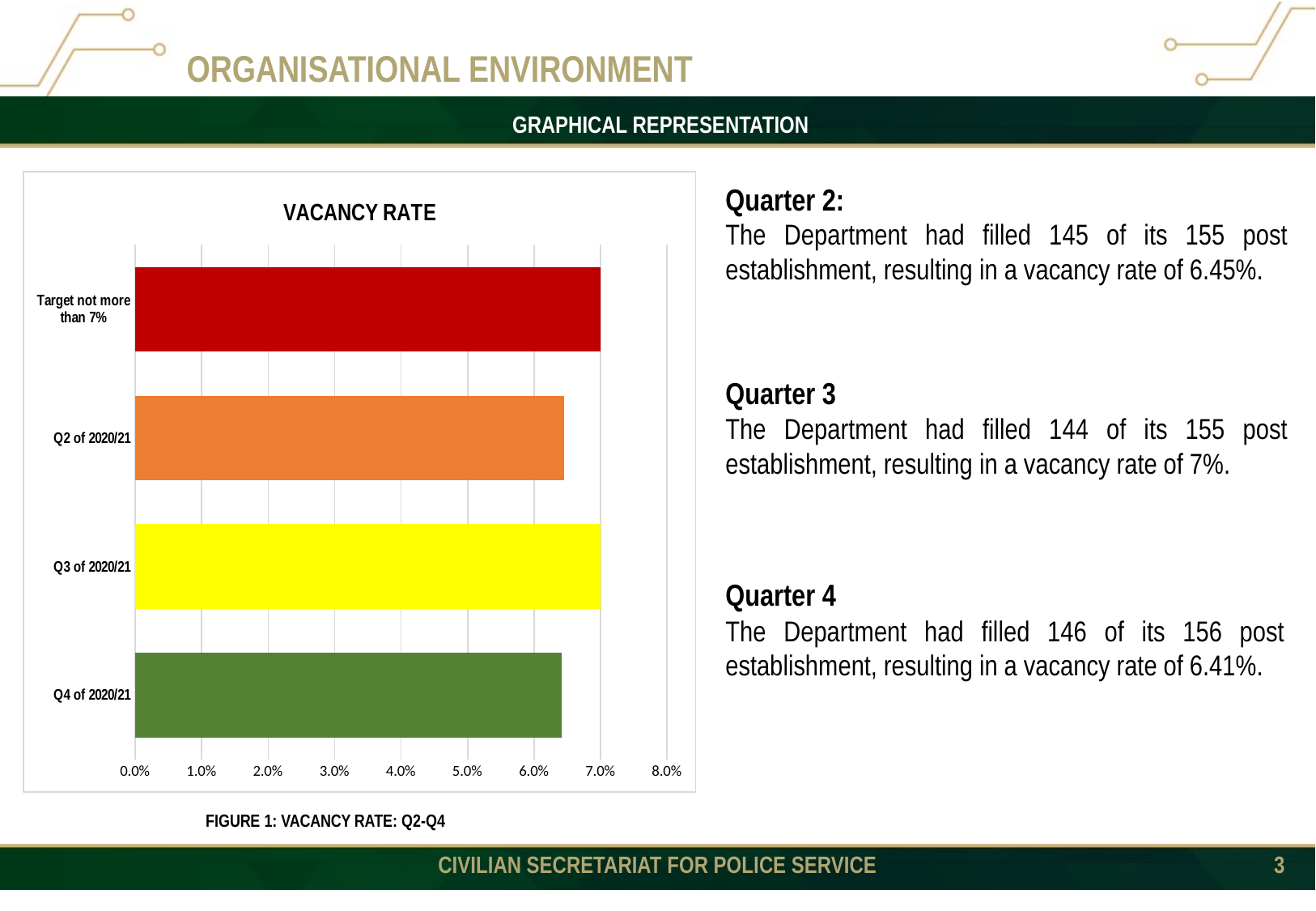
Is the value for Q4 of 2020/21 greater or less than 7.0%? less What is the title of the chart? VACANCY RATE Is the value for Q4 of 2020/21 greater or less than 6.0%? greater Is the value for Q2 of 2020/21 greater or less than 7.0%? less What is the value of the 'Target not more than 7%' bar in the VACANCY RATE chart? 7.0% Which bar is longer, 'Target not more than 7%' or 'Q2 of 2020/21'? Target not more than 7% How many categories are plotted in the VACANCY RATE chart? 4 What colour is the bar for Q3 of 2020/21? yellow What is the vacancy rate shown for Q3 of 2020/21 in the chart? 7.0% Which has the larger value in the chart, Q3 of 2020/21 or Q4 of 2020/21? Q3 of 2020/21 What kind of chart is shown on the slide? bar chart